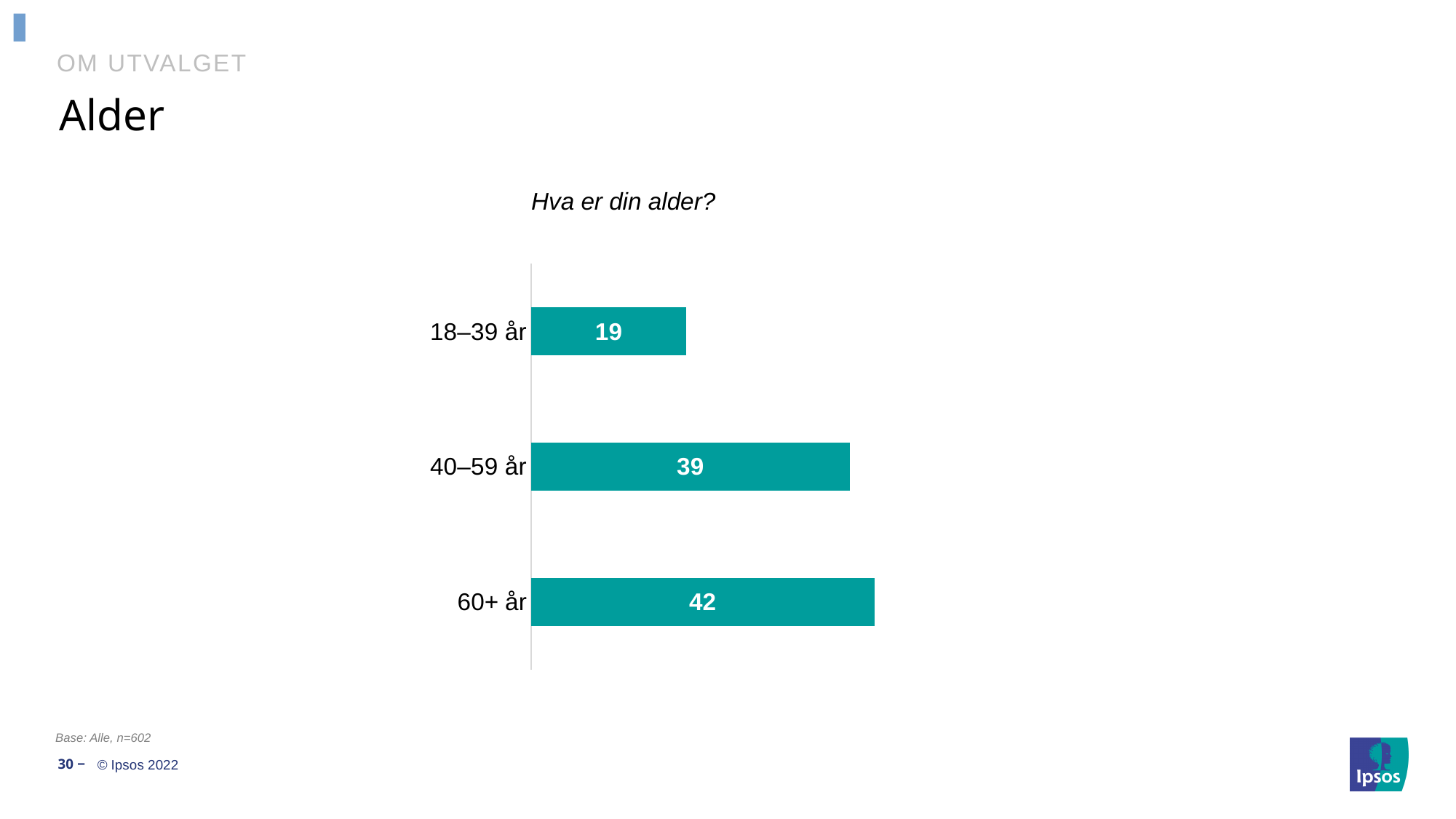
What is the sample size stated in the base note below the chart? n=602 What is the value for the 60+ år category? 42 How many age categories are shown in the chart? 3 What is the difference between the values for 40–59 år and 18–39 år? 20 What is the value for the 18–39 år category? 19 Which age category has the lowest value? 18–39 år What is the difference between the values for 60+ år and 18–39 år? 23 What is the value for the 40–59 år category? 39 Which age category has the highest value? 60+ år What is the title of the chart? Hva er din alder? Which is larger, the value for 40–59 år or the value for 18–39 år? 40–59 år What kind of chart is shown on the slide? Bar chart